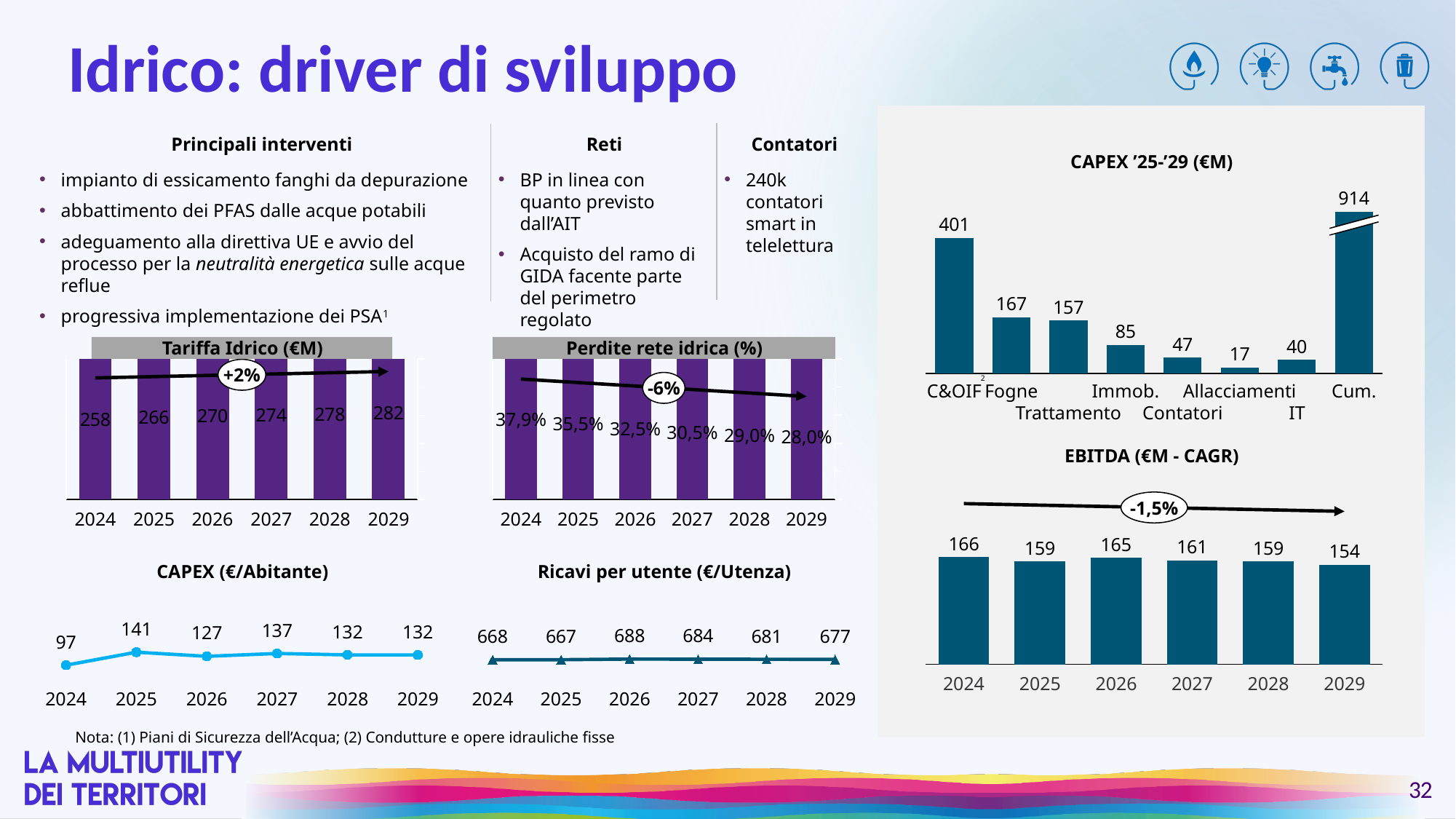
What kind of chart is the "EBITDA (€M - CAGR)" chart? bar chart In the "EBITDA (€M - CAGR)" chart, is the value for 2026 larger than the value for 2025? Yes In the "Tariffa Idrico (€M)" chart, what is the value for 2029? 282 In the "CAPEX '25-'29 (€M)" chart, which category has the lowest value? Allacciamenti In the "Perdite rete idrica (%)" chart, which year has the lowest value? 2029 In the "Perdite rete idrica (%)" chart, what is the value for 2024? 37,9% In the "Ricavi per utente (€/Utenza)" chart, which year has the highest value? 2026 In the "CAPEX (€/Abitante)" chart, what is the value for 2025? 141 In the "CAPEX (€/Abitante)" chart, what is the difference between the 2025 value and the 2024 value? 44 In the "Ricavi per utente (€/Utenza)" chart, how many data points are plotted? 6 In the "Tariffa Idrico (€M)" chart, do the values rise or fall from 2024 to 2029? rise In the "CAPEX '25-'29 (€M)" chart, what is the value for Fogne? 167